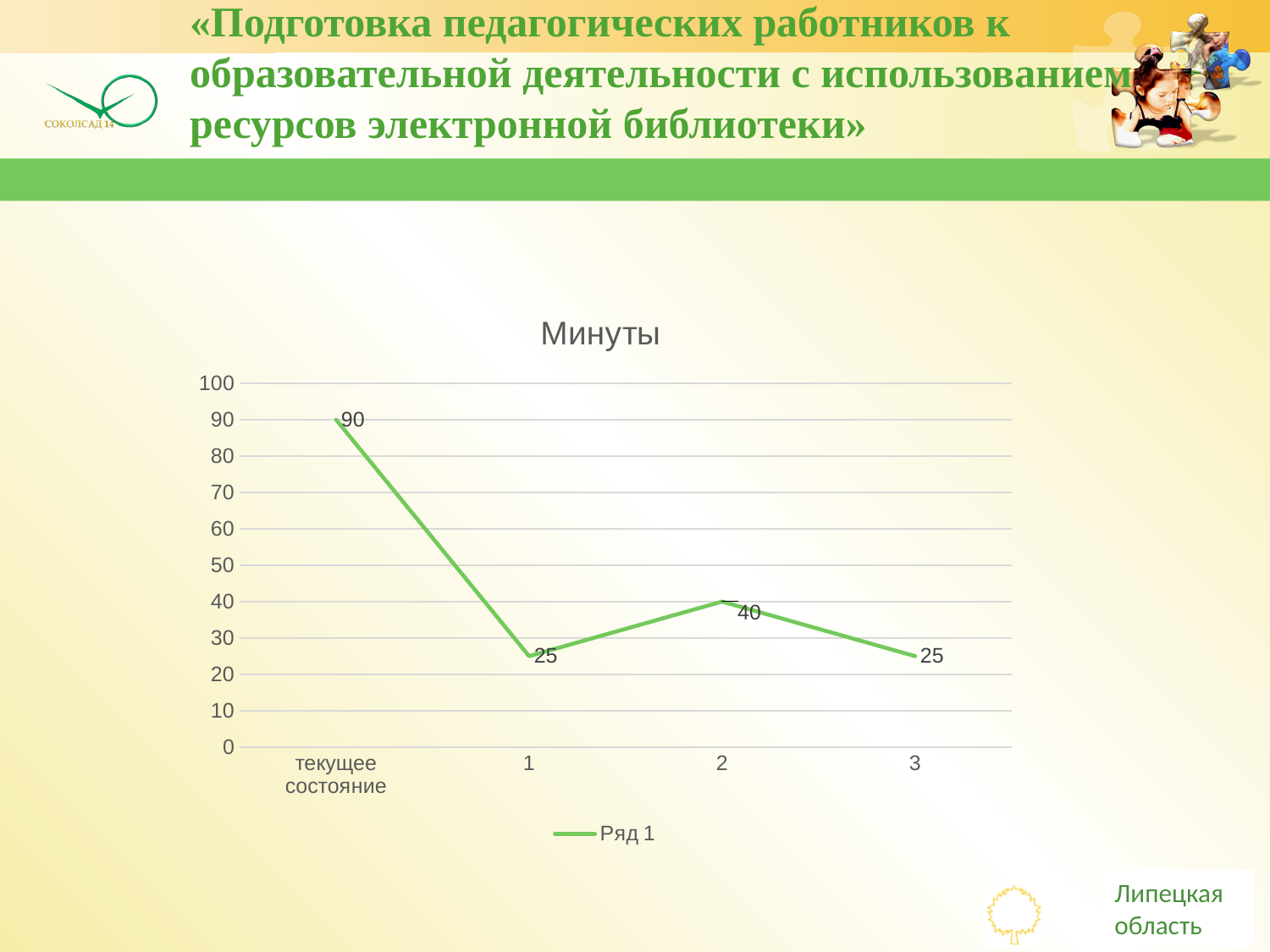
What is the value for category 1 in the chart? 25 How many series does the legend list? 1 What kind of chart is shown on the slide? line chart Which category has the highest value in the chart? текущее состояние Is the value for category 2 greater or less than 50? less Which is larger: the value for category 1 or the value for category 2? category 2 What is the title of the chart? Минуты What is the value for category 2 in the chart? 40 How many categories are shown on the x axis of the chart? 4 What is the value for "текущее состояние" in the chart? 90 What is the difference between the value for "текущее состояние" and the value for category 2? 50 What is the difference between the value for category 2 and the value for category 3? 15